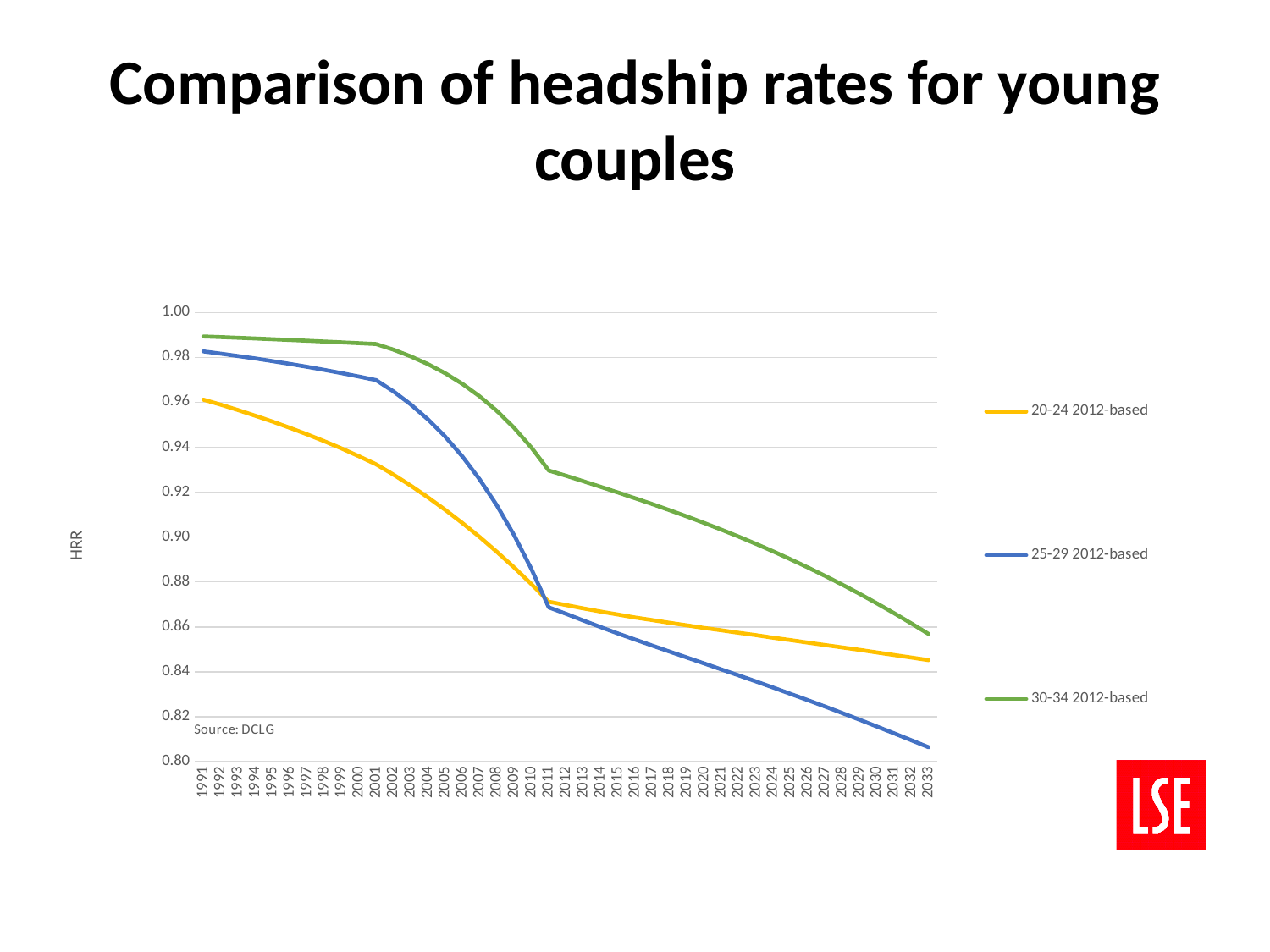
What is the label on the y axis? HRR Which series has the lowest value in 1991? 20-24 2012-based In 2033, which is higher: 20-24 2012-based or 25-29 2012-based? 20-24 2012-based Do the headship rates rise or fall from 1991 to 2033? fall In 2011, which is higher: 30-34 2012-based or 25-29 2012-based? 30-34 2012-based Is the value for 30-34 2012-based in 1991 greater or less than 0.98? greater Is the value for 25-29 2012-based in 2033 greater or less than 0.82? less Which series has the highest value in 2033? 30-34 2012-based What kind of chart is shown on the slide? line chart Is the value for 20-24 2012-based in 1991 greater or less than 0.94? greater How many series does the legend list? 3